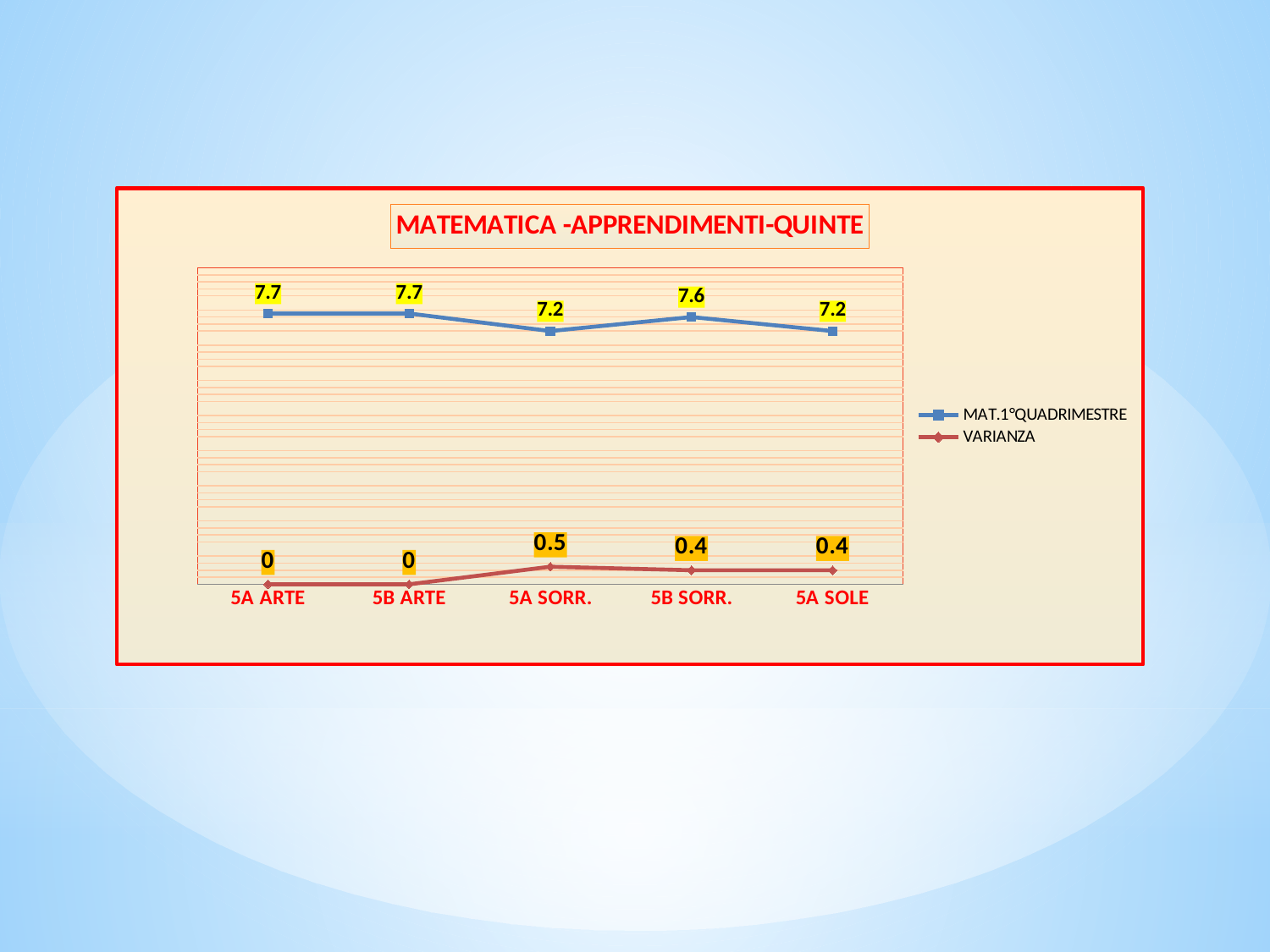
What is the MAT.1°QUADRIMESTRE value for 5A SOLE? 7.2 Which series is drawn in blue? MAT.1°QUADRIMESTRE What is the VARIANZA value for 5A SORR.? 0.5 What is the MAT.1°QUADRIMESTRE value for 5B SORR.? 7.6 Which category has the highest VARIANZA value? 5A SORR. How many series does the legend list? 2 What kind of chart is shown on the slide? Line chart Which category has the highest MAT.1°QUADRIMESTRE value, 5B SORR. or 5A SORR.? 5B SORR. What is the difference between the VARIANZA values for 5A SORR. and 5B SORR.? 0.1 What is the difference between the MAT.1°QUADRIMESTRE values for 5A ARTE and 5A SORR.? 0.5 How many categories are shown on the x axis? 5 What is the title of the chart? MATEMATICA -APPRENDIMENTI-QUINTE